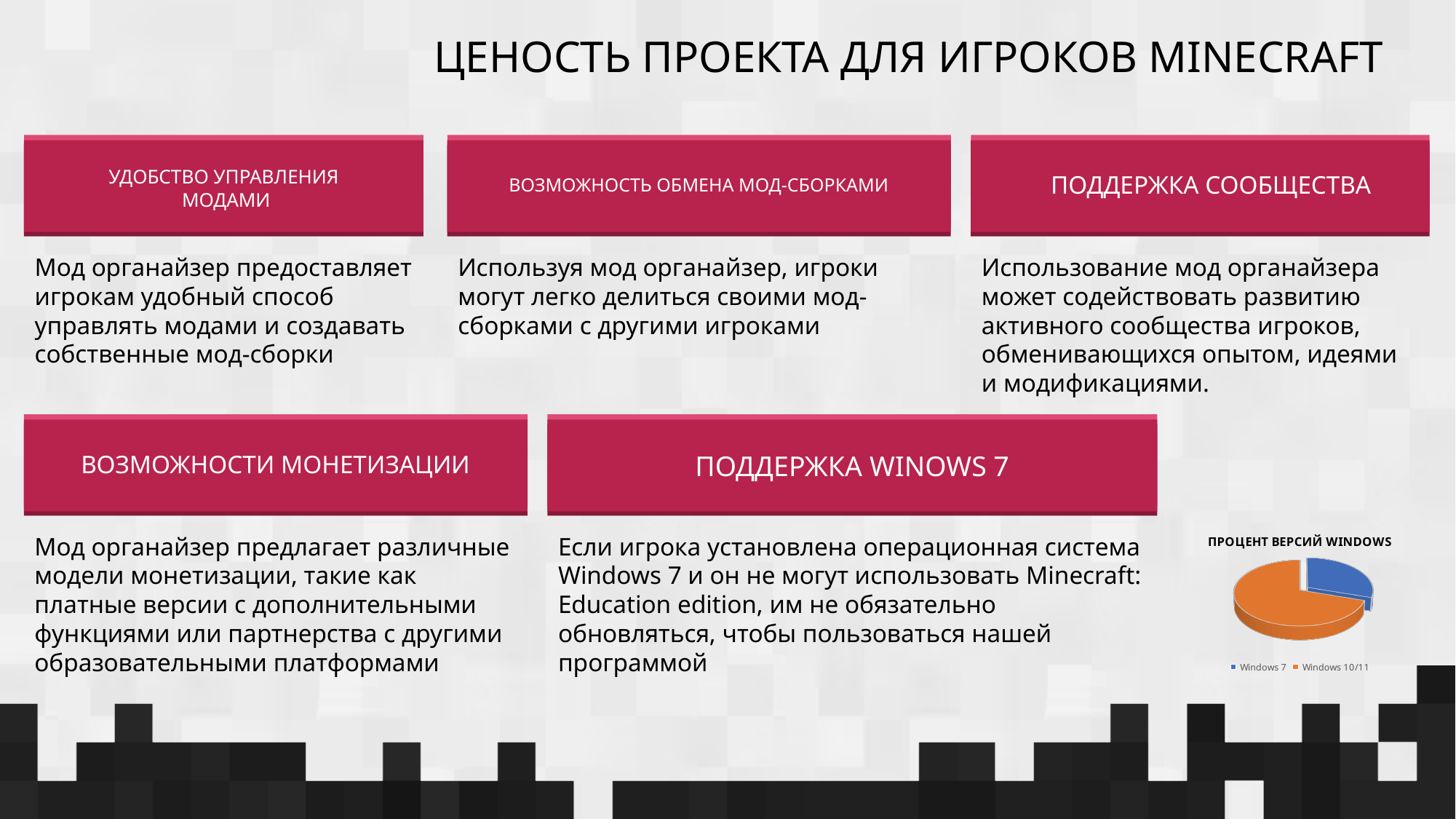
Which slice is larger in the pie chart, Windows 7 or Windows 10/11? Windows 10/11 Which category has the largest slice in the pie chart? Windows 10/11 What kind of chart is shown on the slide? pie chart What is the title of the chart on the slide? ПРОЦЕНТ ВЕРСИЙ WINDOWS Which category in the pie chart is shown in orange? Windows 10/11 What colour is the Windows 7 slice in the pie chart? blue Which category has the smallest slice in the pie chart? Windows 7 How many categories does the pie chart's legend list? 2